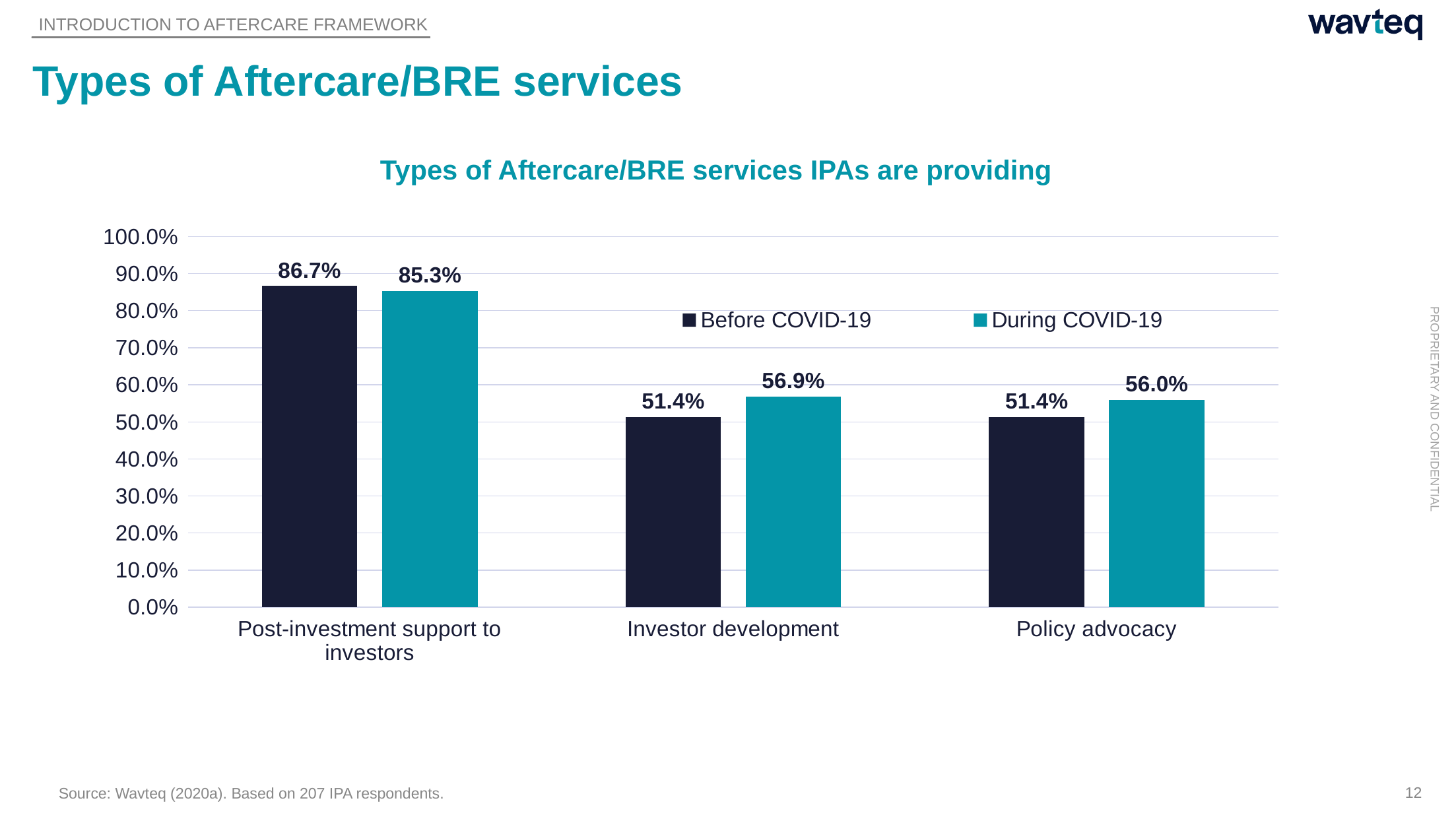
How many categories are shown on the x axis? 3 What is the During COVID-19 value for Policy advocacy? 56.0% How many series does the legend list? 2 For Policy advocacy, which is larger: the Before COVID-19 value or the During COVID-19 value? During COVID-19 Which category has the highest During COVID-19 value? Post-investment support to investors What is the title of the chart? Types of Aftercare/BRE services IPAs are providing What kind of chart is shown on the slide? Bar chart What is the During COVID-19 value for Investor development? 56.9% What is the Before COVID-19 value for Post-investment support to investors? 86.7% What is the Before COVID-19 value for Policy advocacy? 51.4% What is the difference between the Before COVID-19 and During COVID-19 values for Post-investment support to investors? 1.4% What is the difference between the Before COVID-19 and During COVID-19 values for Investor development? 5.5%